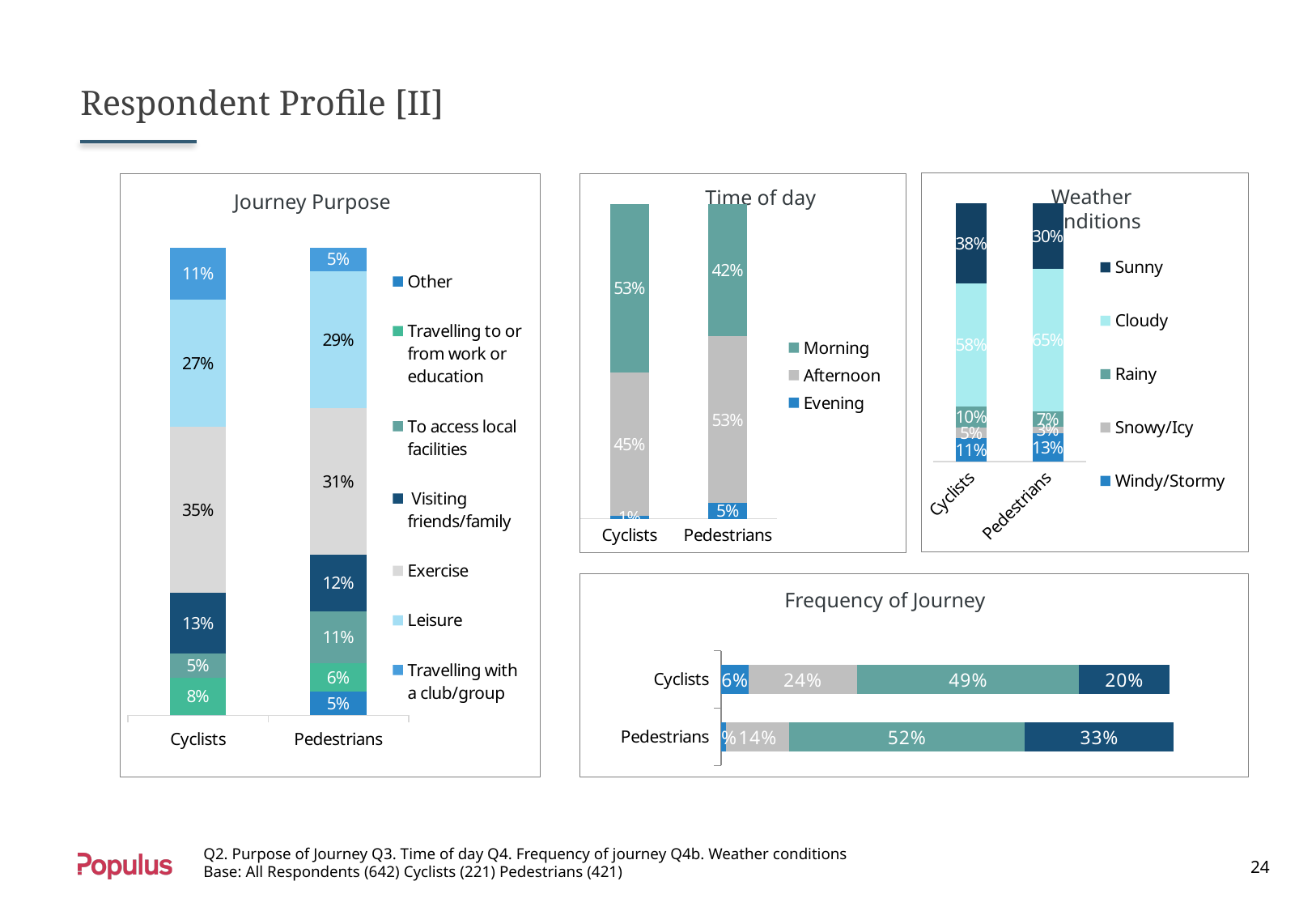
In the Weather Conditions chart, what percentage of Pedestrians reported Cloudy conditions? 65% In the Weather Conditions chart, what is the difference between the Sunny values for Cyclists and Pedestrians? 8 percentage points What type of chart is the Frequency of Journey chart? Stacked horizontal bar chart In the Journey Purpose chart, what percentage of Pedestrians gave Leisure as their journey purpose? 29% In the Weather Conditions chart, which weather condition has the lowest value for Pedestrians? Snowy/Icy In the Journey Purpose chart, what percentage of Cyclists gave Exercise as their journey purpose? 35% How many series does the legend of the Journey Purpose chart list? 7 In the Time of day chart, what is the Evening value for Pedestrians? 5% In the Frequency of Journey chart, what is the value of the largest segment in the Pedestrians bar? 52% In the Time of day chart, which group has the larger Afternoon share, Cyclists or Pedestrians? Pedestrians In the Journey Purpose chart, what is the difference between the Exercise share for Cyclists and for Pedestrians? 4 percentage points In the Time of day chart, what percentage of Cyclists travel in the Morning? 53%